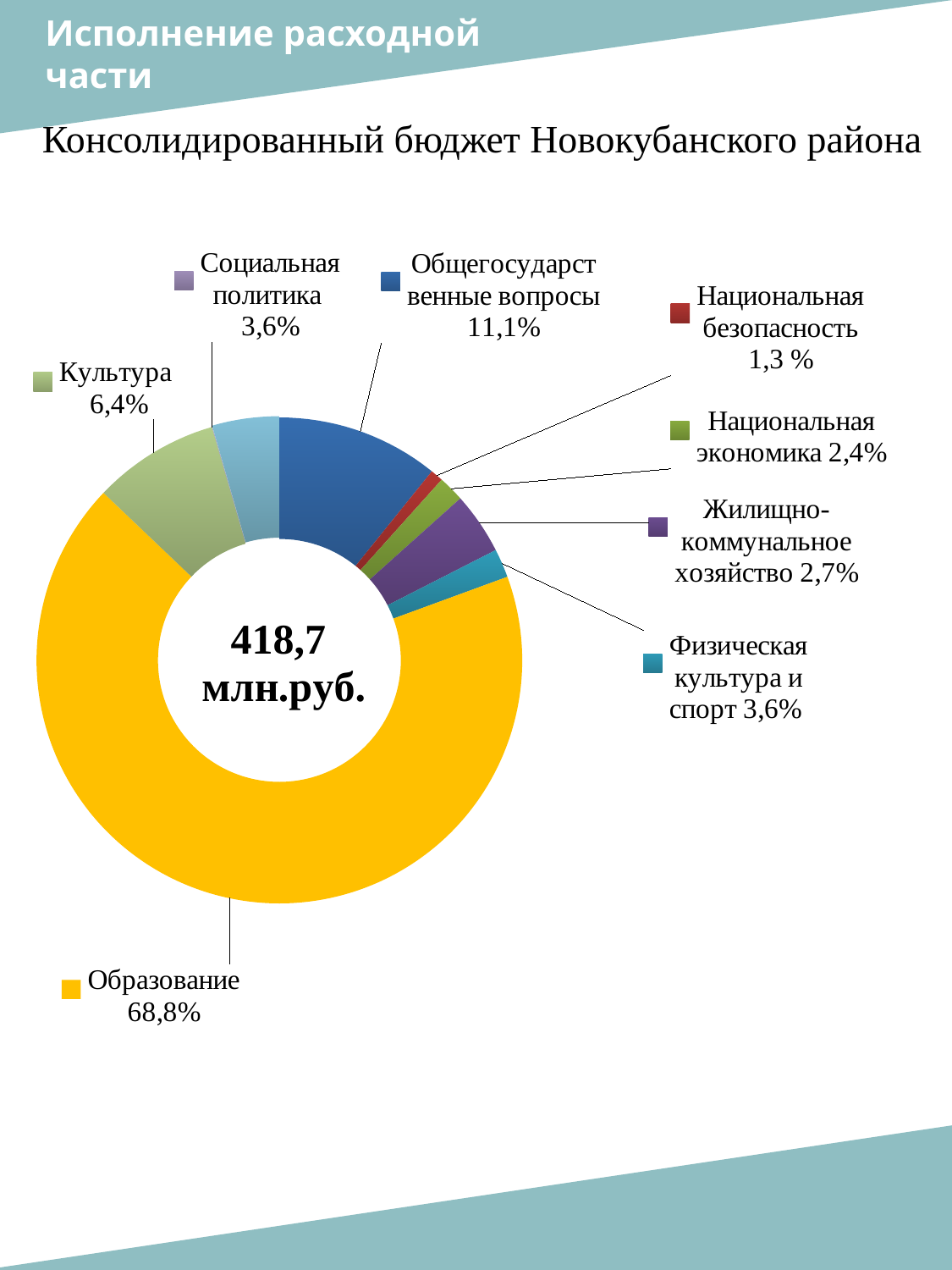
Which is larger: the share for Культура or the share for Национальная экономика? Культура What share of the budget goes to Общегосударственные вопросы? 11,1% What share of the budget goes to Национальная безопасность? 1,3 % How many categories are shown in the chart? 8 What share of the budget goes to Культура? 6,4% What kind of chart is shown on the slide? Doughnut (pie) chart What share of the budget goes to Образование? 68,8% What share of the budget goes to Жилищно-коммунальное хозяйство? 2,7% Which category has the largest share of the budget? Образование What is the difference in percentage points between Образование and Общегосударственные вопросы? 57,7 What total amount is shown in the centre of the chart? 418,7 млн.руб. Which category has the smallest share of the budget? Национальная безопасность